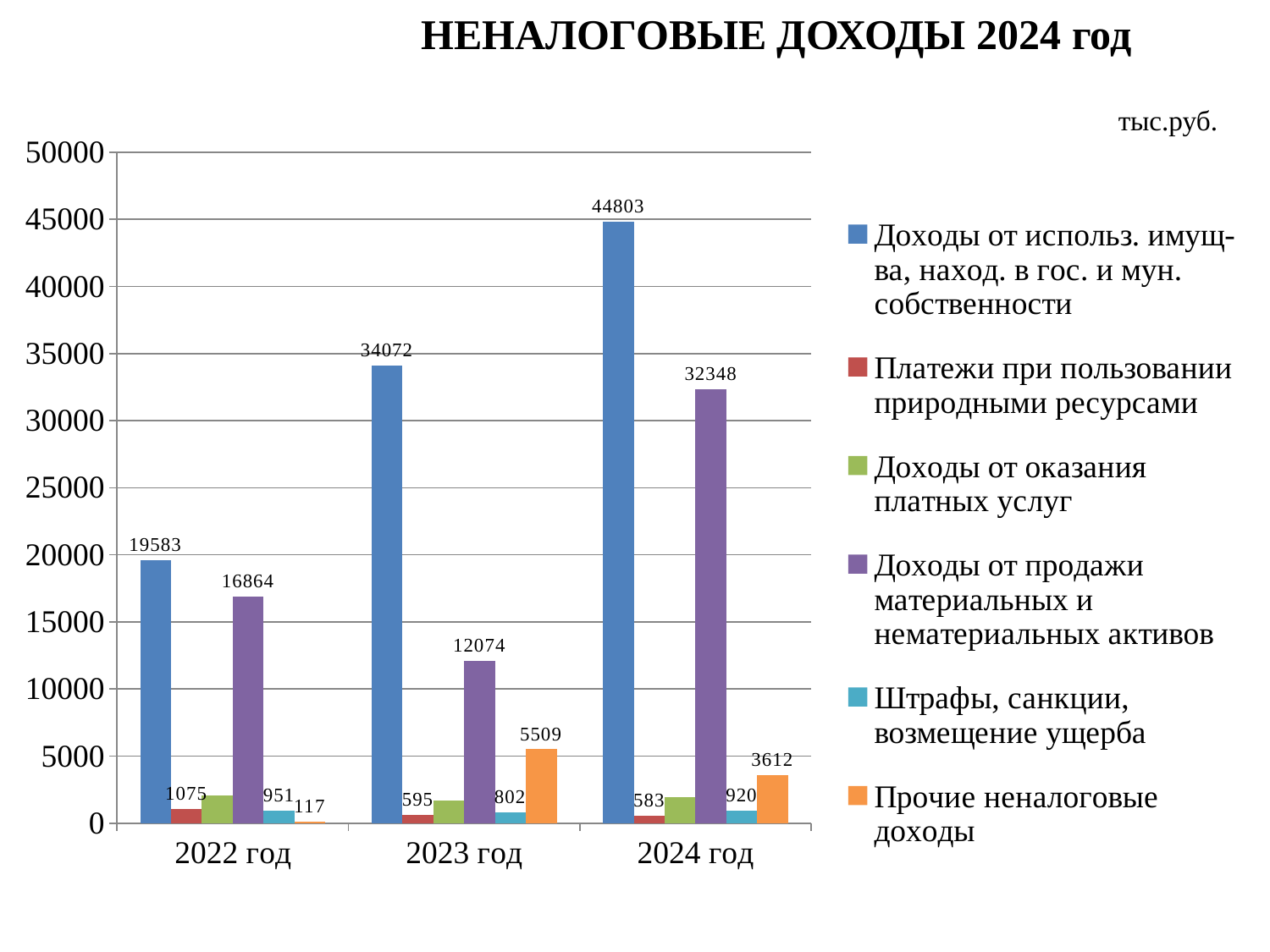
How many series does the legend list? 6 Which is larger: 'Платежи при пользовании природными ресурсами' in 2022 год or in 2023 год? 2022 год Is the value for 'Доходы от оказания платных услуг' in 2023 год greater or less than 5000? less What is the difference between 'Доходы от использ. имущ-ва, наход. в гос. и мун. собственности' in 2024 год and in 2023 год? 10731 What is the value for 'Штрафы, санкции, возмещение ущерба' in 2024 год? 920 What is the value for 'Доходы от использ. имущ-ва, наход. в гос. и мун. собственности' in 2024 год? 44803 In which year is 'Доходы от использ. имущ-ва, наход. в гос. и мун. собственности' highest? 2024 год What kind of chart is shown on the slide? bar chart In which year is 'Прочие неналоговые доходы' lowest? 2022 год What is the value for 'Доходы от продажи материальных и нематериальных активов' in 2022 год? 16864 How many years are shown on the x axis? 3 What is the value for 'Прочие неналоговые доходы' in 2023 год? 5509